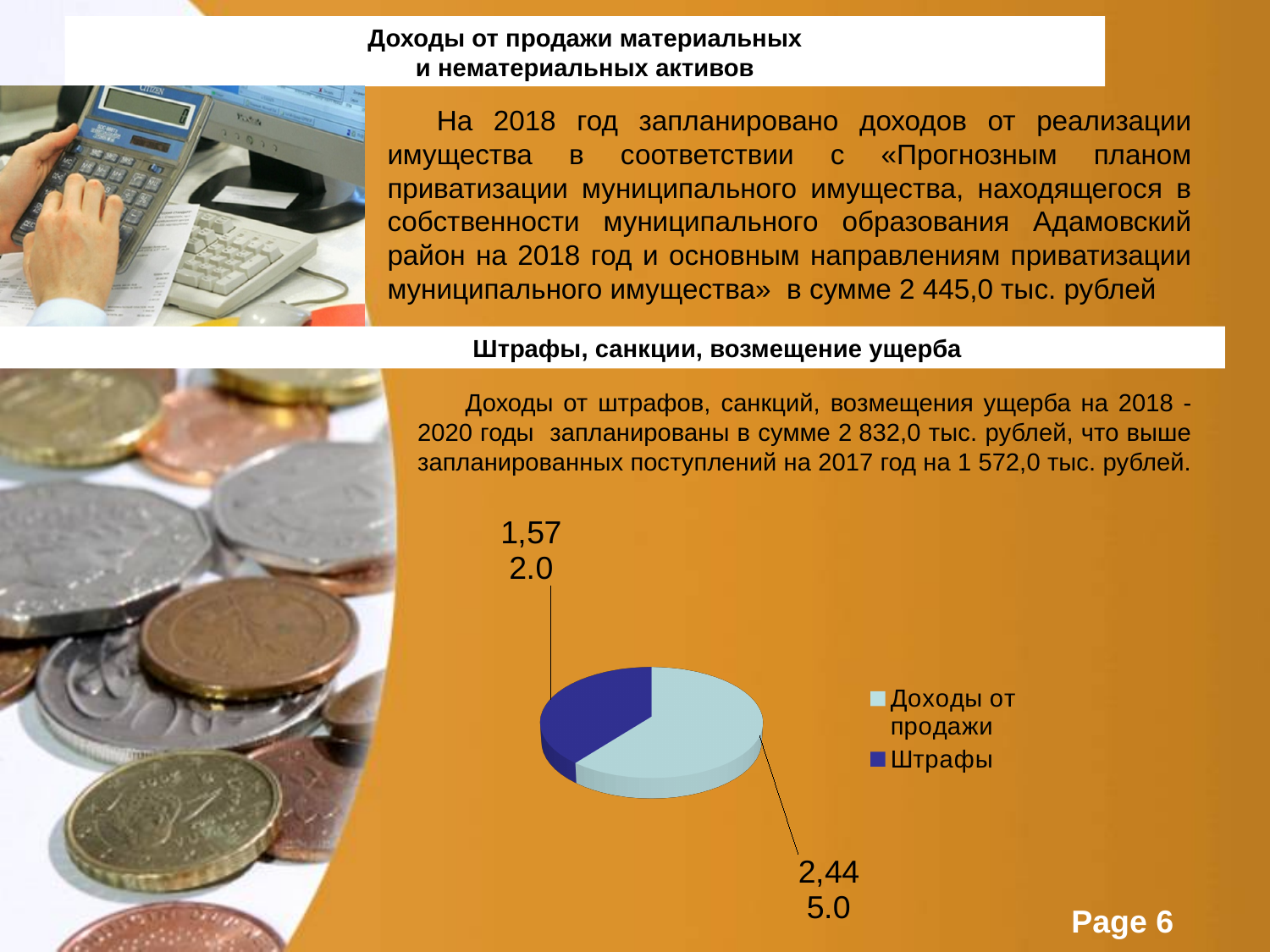
Which legend entry of the pie chart is shown in light blue? Доходы от продажи Which slice of the pie chart is the largest? Доходы от продажи What is the value shown for the 'Доходы от продажи' slice of the pie chart? 2,445.0 Which slice of the pie chart is the smallest? Штрафы What is the total of the two values shown in the pie chart? 4,017.0 How many entries does the legend of the pie chart list? 2 What kind of chart is shown on the slide? pie chart What is the value shown for the 'Штрафы' slice of the pie chart? 1,572.0 What colour is the 'Штрафы' slice in the pie chart? dark blue Which is larger in the pie chart: 'Доходы от продажи' or 'Штрафы'? Доходы от продажи What is the difference between the 'Доходы от продажи' and 'Штрафы' values in the pie chart? 873.0 How many slices does the pie chart have? 2